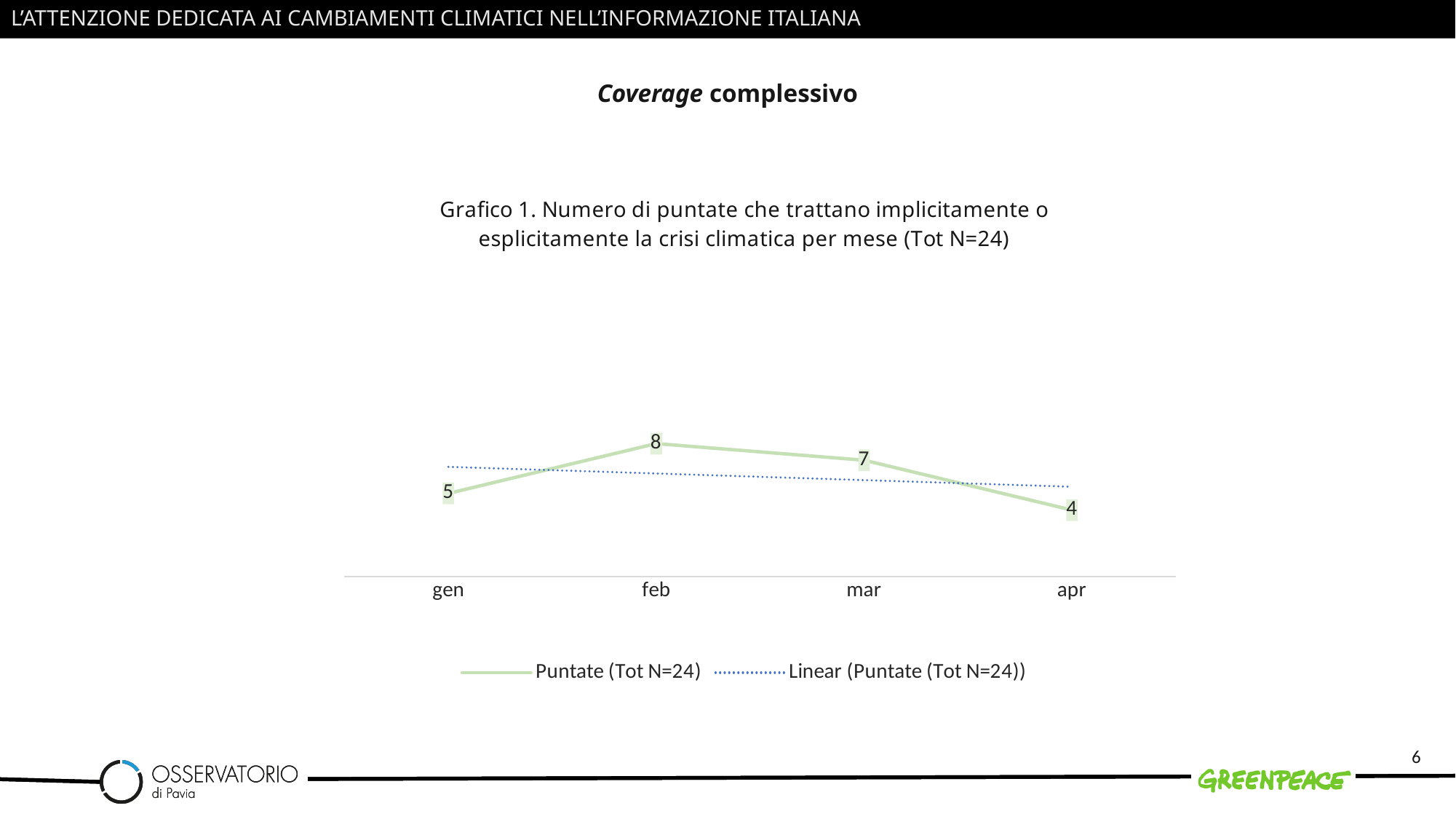
Which month has the lowest value? apr What is the name of the dotted series in the legend? Linear (Puntate (Tot N=24)) What is the value for feb? 8 What is the value for apr? 4 How many entries does the legend list? 2 How many months are plotted on the x axis? 4 What is the difference between the values for feb and apr? 4 Do the values rise or fall from feb to apr? fall Which is larger, the value for gen or the value for mar? mar What kind of chart is this? line chart Which month has the highest value? feb What is the value for gen? 5